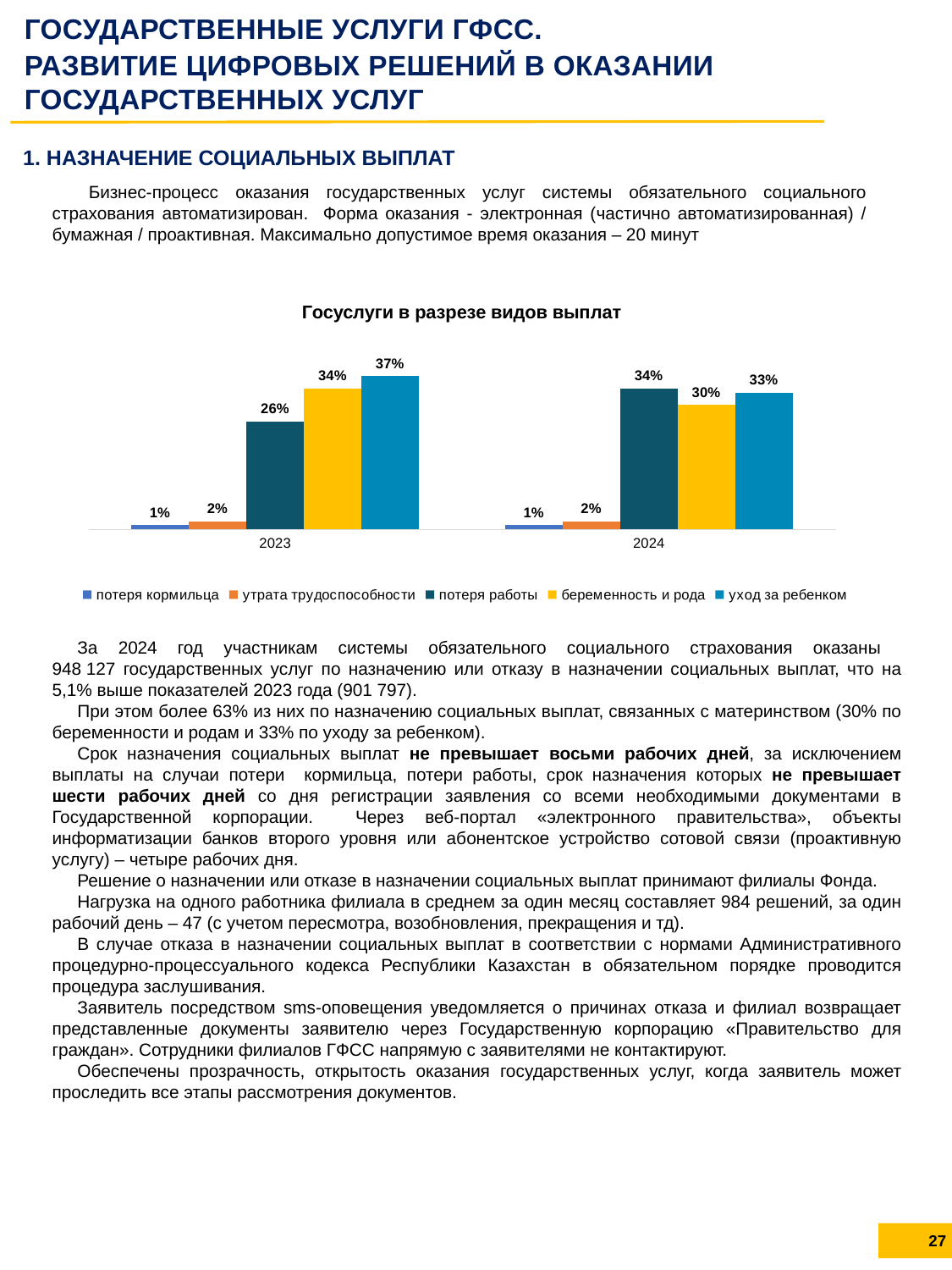
Which is larger in 2024: 'беременность и рода' or 'уход за ребенком'? уход за ребенком What is the value for 'беременность и рода' in 2024? 30% Which payment type has the highest share in 2023? уход за ребенком What is the value for 'потеря работы' in 2024? 34% What is the value for 'утрата трудоспособности' in 2023? 2% What kind of chart is shown? bar chart What is the value for 'уход за ребенком' in 2023? 37% How many year categories are shown on the x axis? 2 What is the title of the chart? Госуслуги в разрезе видов выплат How many series does the legend list? 5 What is the difference between the 'потеря работы' values for 2024 and 2023? 8% Which payment type has the lowest share in 2024? потеря кормильца